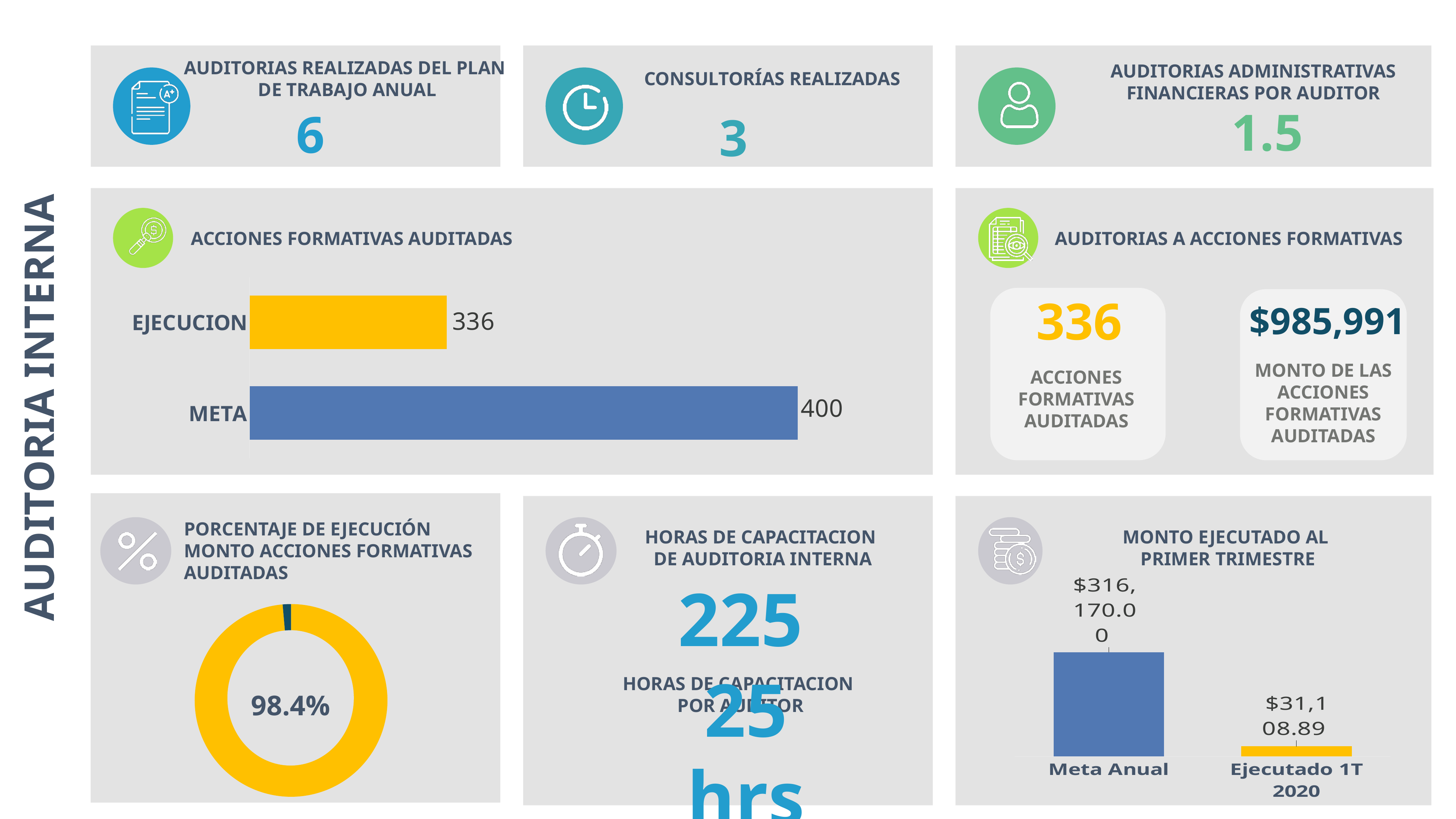
In the 'ACCIONES FORMATIVAS AUDITADAS' chart, how many bars are plotted? 2 In the 'ACCIONES FORMATIVAS AUDITADAS' chart, which category has the higher value? META In the 'MONTO EJECUTADO AL PRIMER TRIMESTRE' chart, which category has the lower value? Ejecutado 1T 2020 In the 'ACCIONES FORMATIVAS AUDITADAS' chart, what is the value for EJECUCION? 336 In the 'ACCIONES FORMATIVAS AUDITADAS' chart, what is the difference between META and EJECUCION? 64 What kind of chart is shown under 'PORCENTAJE DE EJECUCIÓN MONTO ACCIONES FORMATIVAS AUDITADAS'? Donut chart What percentage is shown in the donut chart under 'PORCENTAJE DE EJECUCIÓN MONTO ACCIONES FORMATIVAS AUDITADAS'? 98.4% In the 'MONTO EJECUTADO AL PRIMER TRIMESTRE' chart, is Meta Anual larger or smaller than Ejecutado 1T 2020? Larger What kind of chart is 'ACCIONES FORMATIVAS AUDITADAS'? Bar chart In the 'MONTO EJECUTADO AL PRIMER TRIMESTRE' chart, what is the value for Meta Anual? $316,170.00 In the 'MONTO EJECUTADO AL PRIMER TRIMESTRE' chart, what is the value for Ejecutado 1T 2020? $31,108.89 In the 'ACCIONES FORMATIVAS AUDITADAS' chart, what is the value for META? 400